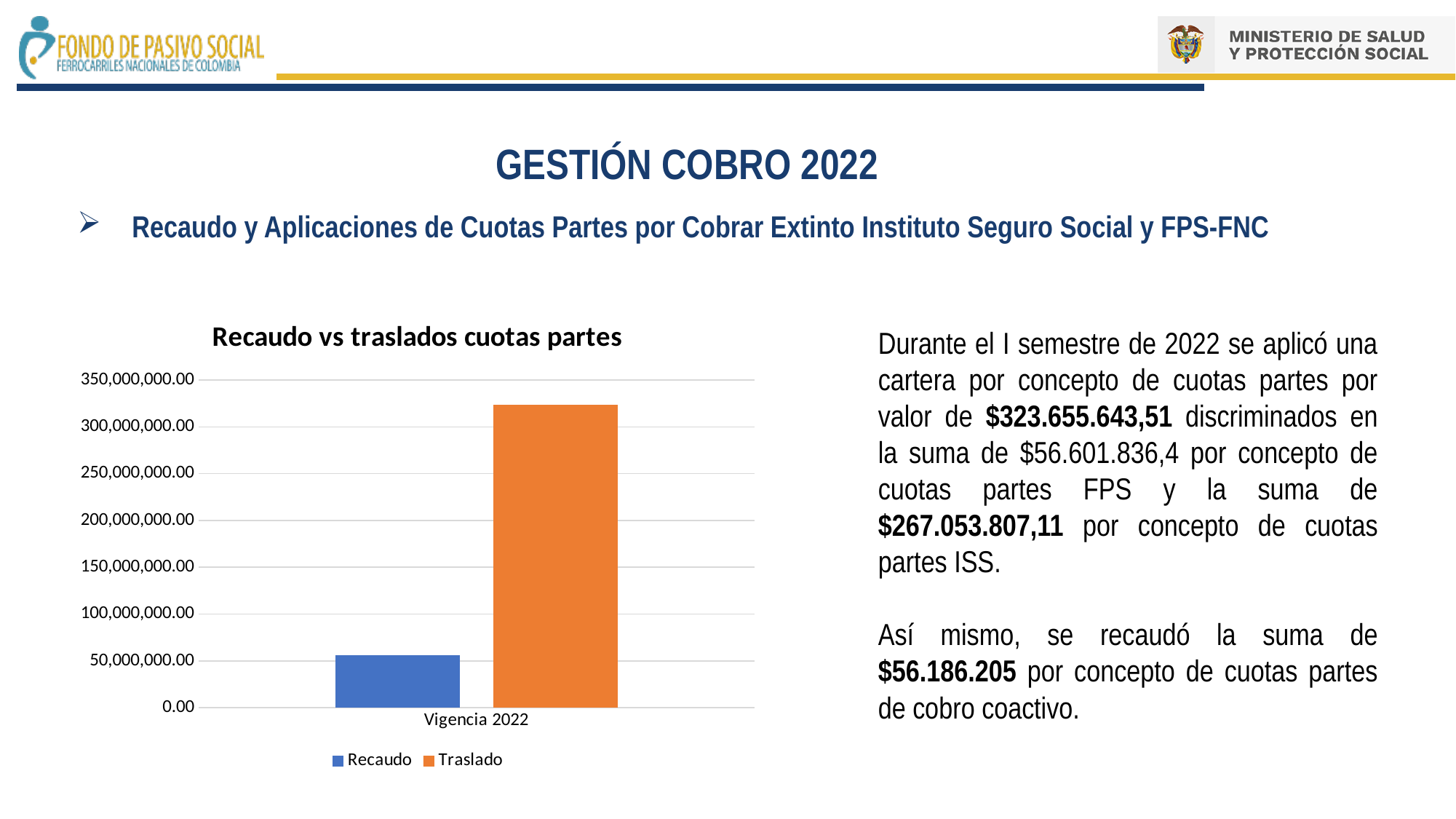
Is the value for Recaudo greater or less than 100,000,000.00? less How many categories are shown on the x axis of the chart? 1 Is the value for Recaudo greater or less than 150,000,000.00? less Which is larger for Vigencia 2022, Recaudo or Traslado? Traslado What is the category label on the x axis of the chart? Vigencia 2022 How many series does the chart legend list? 2 What kind of chart is shown on the slide? bar chart What is the title of the chart? Recaudo vs traslados cuotas partes Which series has the highest value in the chart? Traslado Which series has the lowest value in the chart? Recaudo Is the value for Traslado greater or less than 300,000,000.00? greater